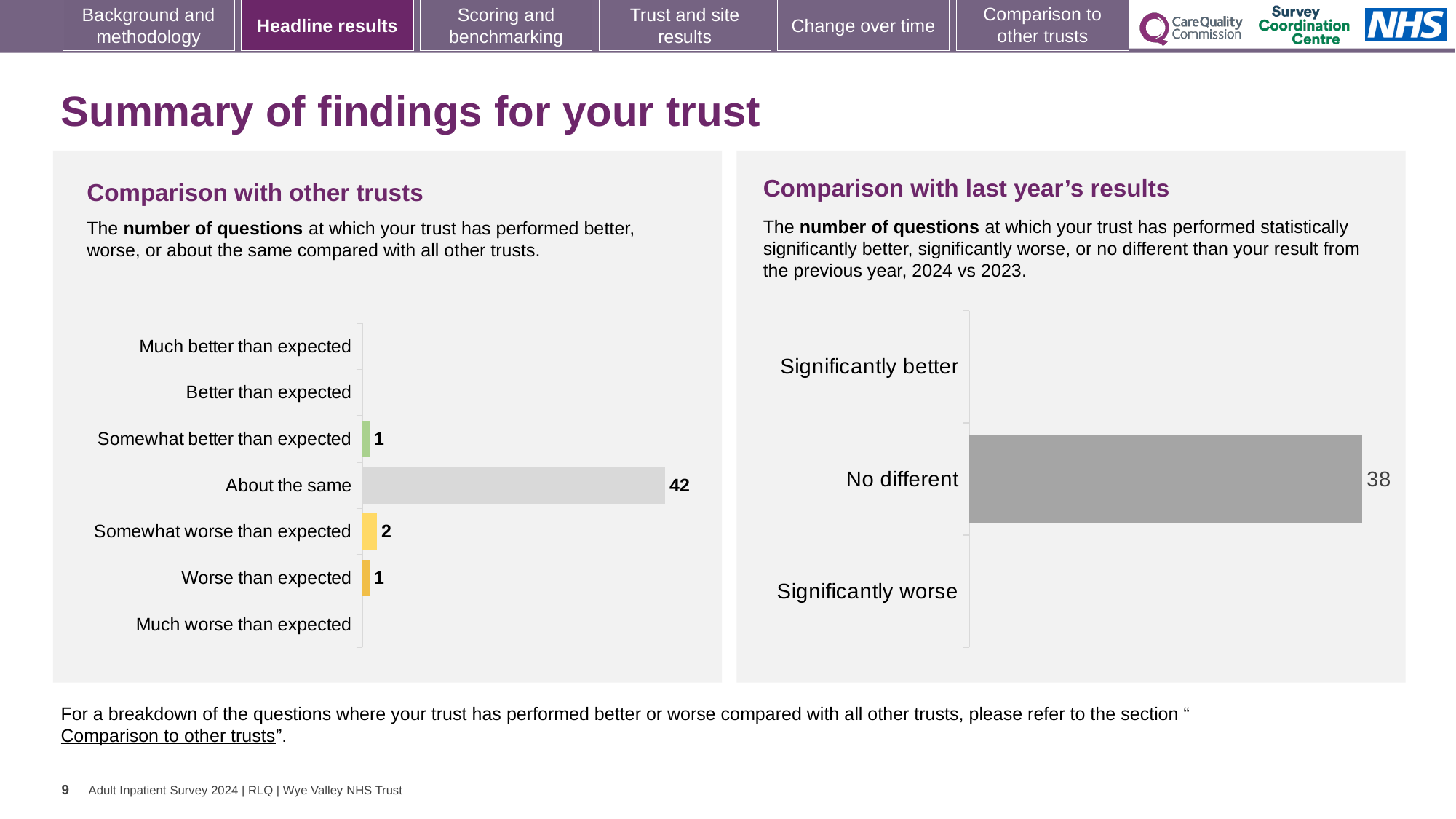
In the 'Comparison with other trusts' chart, what is the value for 'About the same'? 42 In the 'Comparison with other trusts' chart, what is the difference between 'About the same' and 'Somewhat worse than expected'? 40 What kind of chart is the 'Comparison with last year's results' chart? Bar chart What is the title of the chart on the left side of the slide? Comparison with other trusts In the 'Comparison with other trusts' chart, which category has the highest value? About the same How many categories are shown on the y axis of the 'Comparison with other trusts' chart? 7 In the 'Comparison with other trusts' chart, what is the value for 'Somewhat worse than expected'? 2 In the 'Comparison with other trusts' chart, which is larger: 'Somewhat worse than expected' or 'Worse than expected'? Somewhat worse than expected In the 'Comparison with last year's results' chart, what is the value for 'No different'? 38 How many categories are shown on the y axis of the 'Comparison with last year's results' chart? 3 In the 'Comparison with other trusts' chart, what is the value for 'Somewhat better than expected'? 1 In the 'Comparison with other trusts' chart, what is the value for 'Worse than expected'? 1